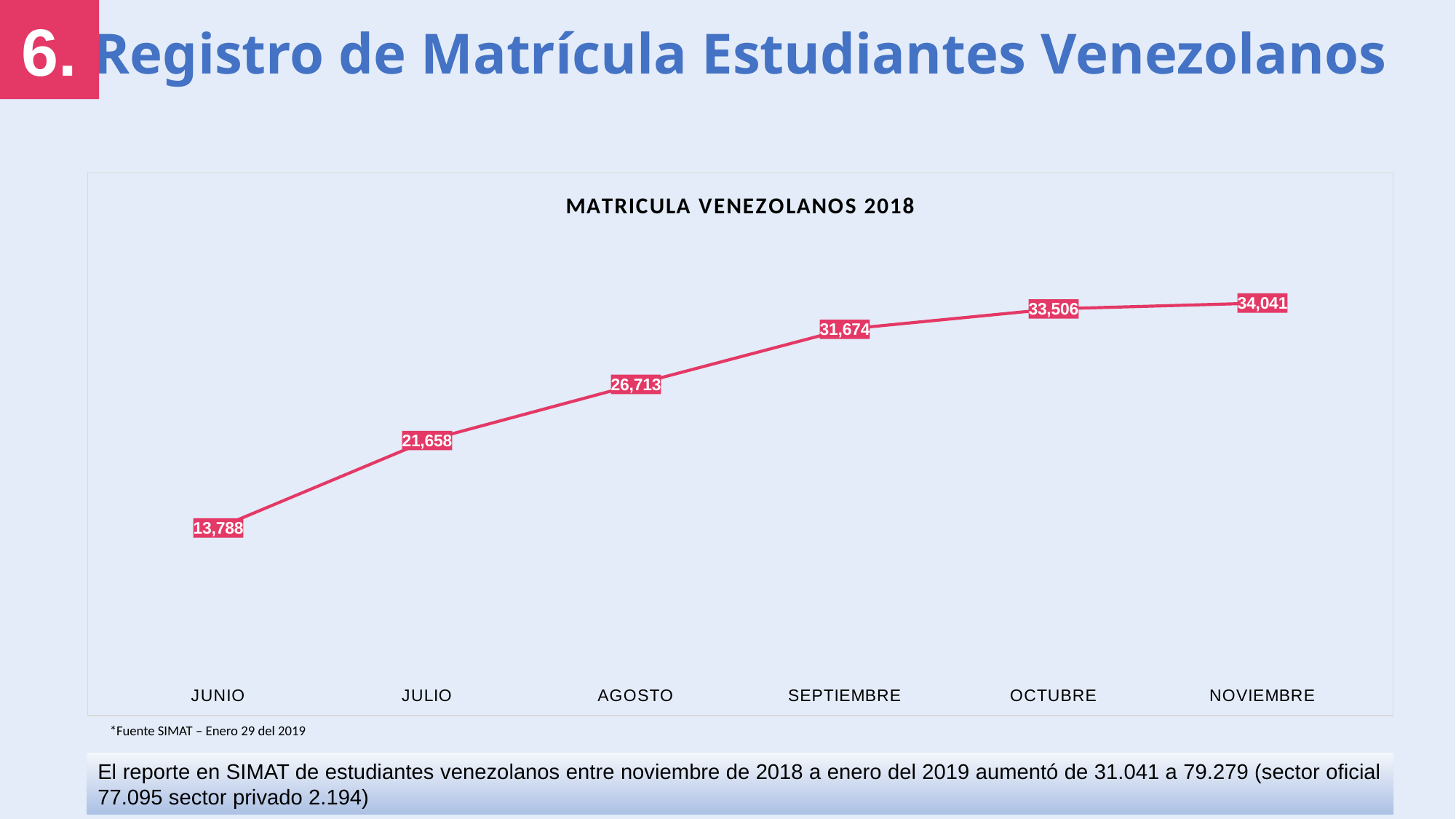
Which month has the highest value? NOVIEMBRE What is the title of the chart? MATRICULA VENEZOLANOS 2018 What is the difference between the values for JULIO and JUNIO? 7,870 How many months are plotted on the chart? 6 Which month has the lowest value? JUNIO What kind of chart is shown? line chart Which is larger, the value for AGOSTO or the value for JULIO? AGOSTO What is the value for SEPTIEMBRE? 31,674 What is the value for NOVIEMBRE? 34,041 What is the value for JUNIO? 13,788 Do the values rise or fall from JUNIO to NOVIEMBRE? rise What is the difference between the values for NOVIEMBRE and OCTUBRE? 535